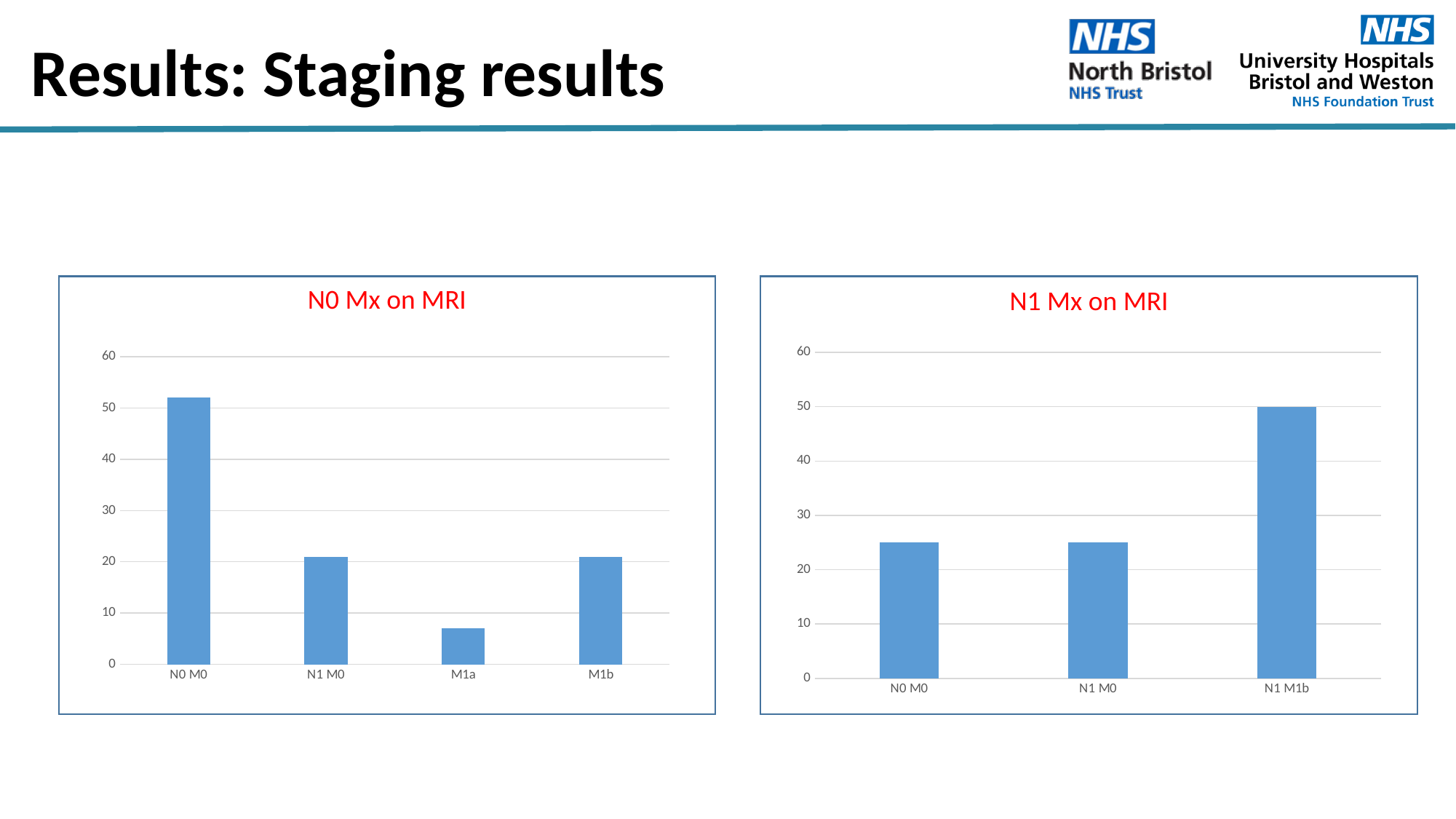
How many categories are shown on the 'N0 Mx on MRI' chart? 4 On the 'N0 Mx on MRI' chart, which category has the lowest value? M1a On the 'N1 Mx on MRI' chart, is the value for N1 M1b greater or less than 40? greater On the 'N0 Mx on MRI' chart, is the value for N0 M0 greater or less than 50? greater On the 'N1 Mx on MRI' chart, which category has the highest value? N1 M1b How many categories are shown on the 'N1 Mx on MRI' chart? 3 On the 'N0 Mx on MRI' chart, is the value for M1a greater or less than 10? less What kind of chart is the 'N0 Mx on MRI' chart? bar chart On the 'N0 Mx on MRI' chart, which is larger, the value for N1 M0 or the value for M1a? N1 M0 On the 'N0 Mx on MRI' chart, which category has the highest value? N0 M0 What is the title of the chart on the right side of the slide? N1 Mx on MRI